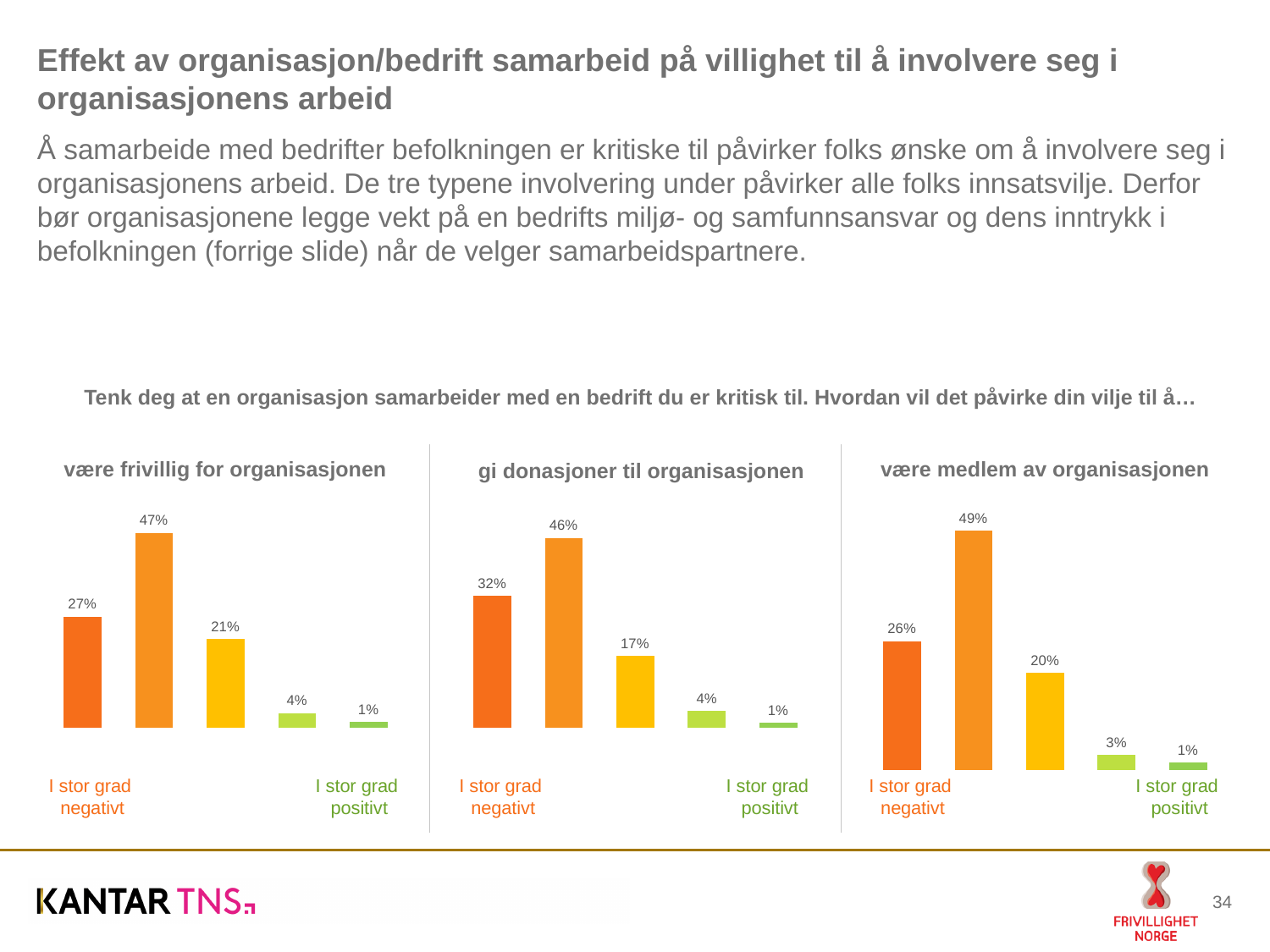
What kind of chart is the chart titled "gi donasjoner til organisasjonen"? Bar chart How many bars are shown in the chart titled "være frivillig for organisasjonen"? 5 In the chart titled "være medlem av organisasjonen", what is the value of the tallest bar? 49% Which is larger: the "I stor grad negativt" value in the chart "gi donasjoner til organisasjonen" or in the chart "være medlem av organisasjonen"? gi donasjoner til organisasjonen In the chart titled "gi donasjoner til organisasjonen", what is the value for "I stor grad negativt"? 32% In the chart titled "være frivillig for organisasjonen", what is the value for "I stor grad negativt"? 27% In the chart titled "være medlem av organisasjonen", what is the value for "I stor grad positivt"? 1% In the chart titled "gi donasjoner til organisasjonen", what is the value of the shortest bar? 1% In the chart titled "gi donasjoner til organisasjonen", what is the value of the tallest bar? 46% In the chart titled "være medlem av organisasjonen", what is the value of the middle (yellow) bar? 20% How many charts are shown on the slide? 3 In the chart titled "være frivillig for organisasjonen", what is the difference between the values for "I stor grad negativt" and "I stor grad positivt"? 26 percentage points